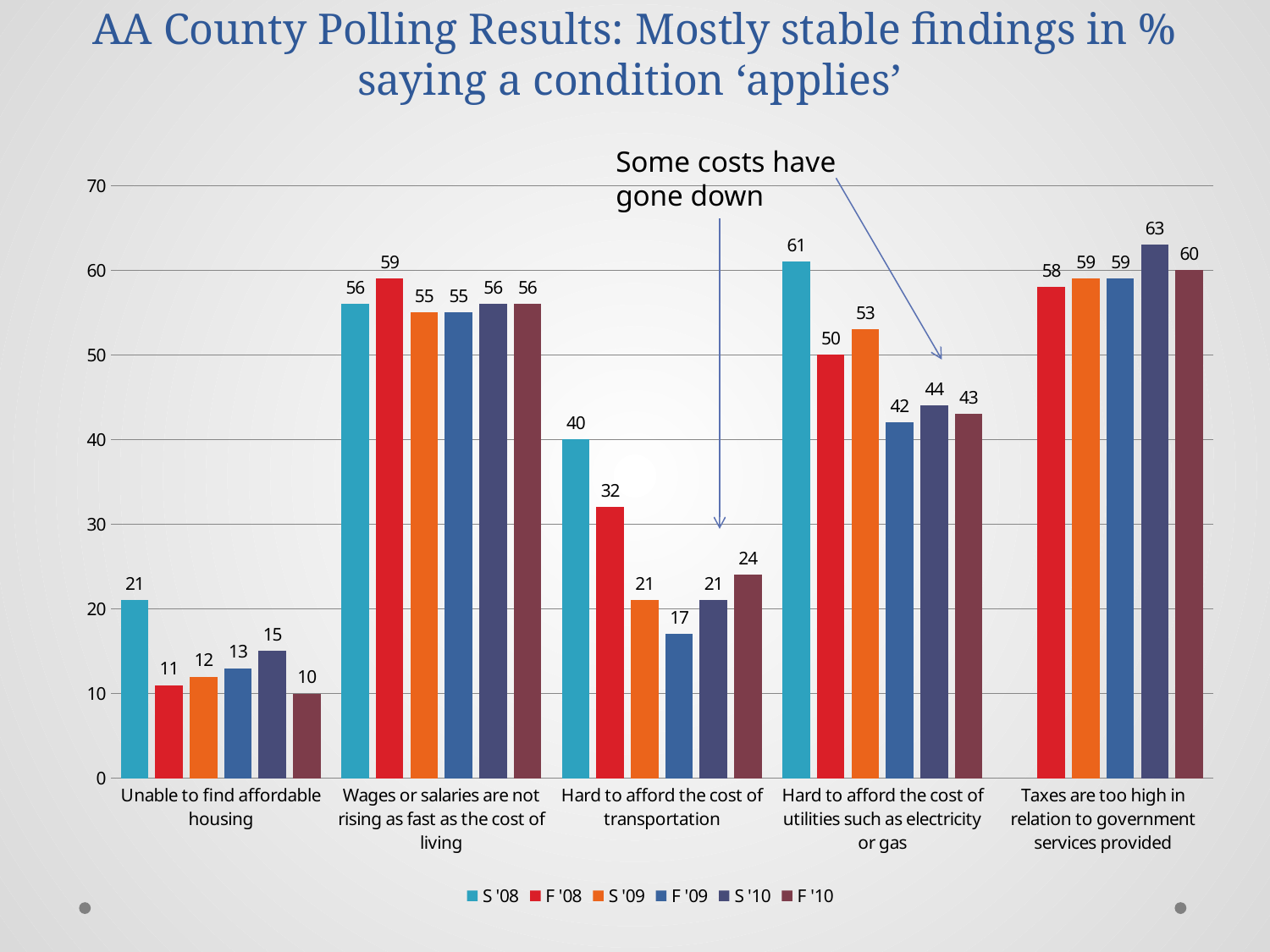
How many series does the legend list? 6 Which survey wave has the lowest value for 'Unable to find affordable housing'? F '10 What does the annotation text above the chart say? Some costs have gone down What kind of chart is shown on the slide? bar chart What is the F '10 value for 'Hard to afford the cost of transportation'? 24 Which survey wave has the highest value for 'Hard to afford the cost of utilities such as electricity or gas'? S '08 What is the difference between the S '08 and F '09 values for 'Hard to afford the cost of transportation'? 23 Which is larger: the F '08 value for 'Wages or salaries are not rising as fast as the cost of living' or the F '08 value for 'Hard to afford the cost of utilities such as electricity or gas'? Wages or salaries are not rising as fast as the cost of living Is the S '10 value for 'Hard to afford the cost of utilities such as electricity or gas' greater or less than 50? less What is the S '08 value for 'Unable to find affordable housing'? 21 How many categories are shown on the x axis? 5 What is the S '10 value for 'Taxes are too high in relation to government services provided'? 63